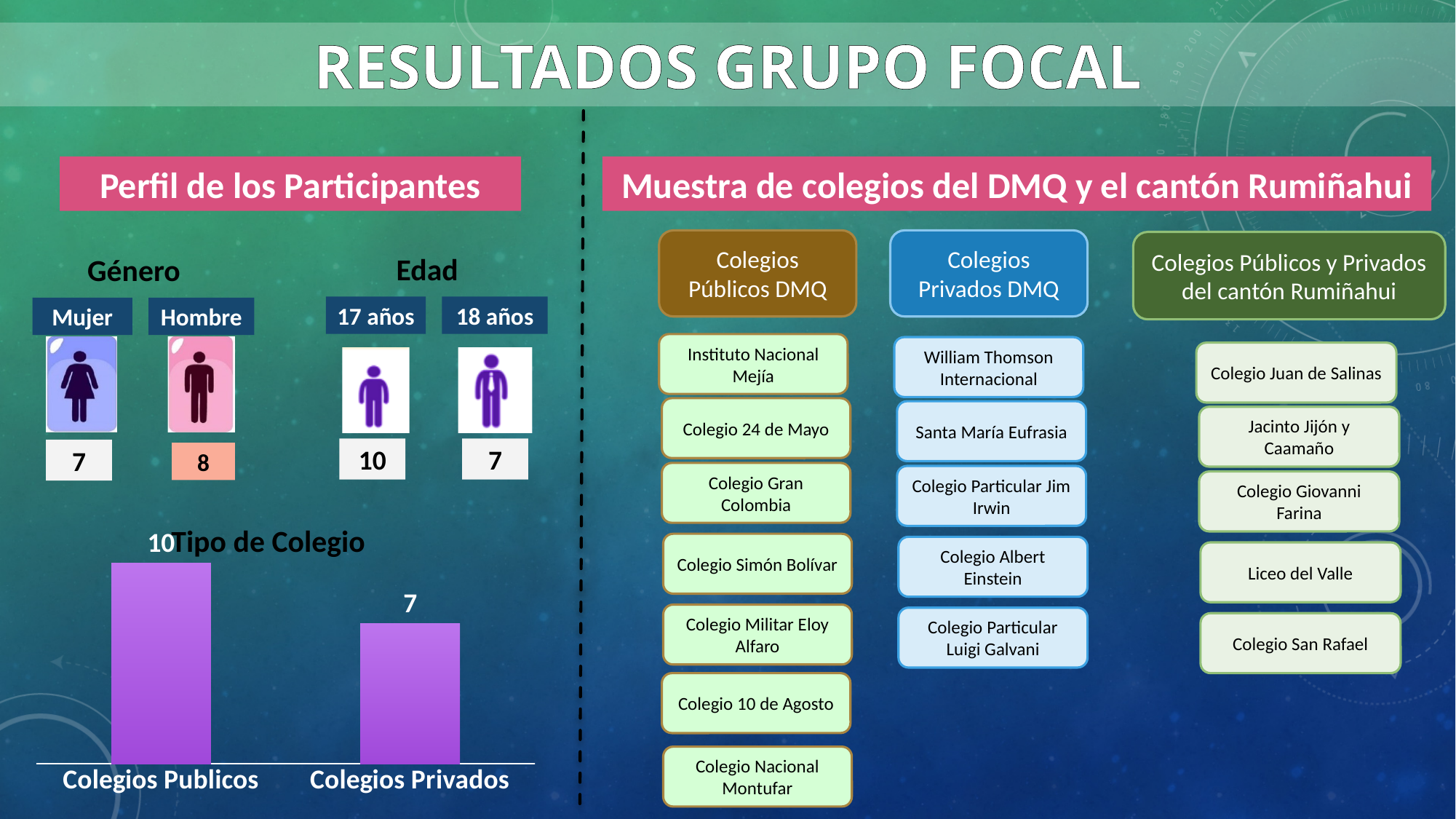
In the "Tipo de Colegio" chart, what is the value for Colegios Publicos? 10 In the "Tipo de Colegio" chart, do the values rise or fall from left to right? Fall What is the total of the two values shown in the "Tipo de Colegio" chart? 17 How many categories does the "Tipo de Colegio" chart show? 2 In the "Tipo de Colegio" chart, which category has the lowest value? Colegios Privados What colour are the bars in the "Tipo de Colegio" chart? Purple What kind of chart is the "Tipo de Colegio" chart? Bar chart In the "Tipo de Colegio" chart, which category has the highest value? Colegios Publicos What is the title of the bar chart on the slide? Tipo de Colegio In the "Tipo de Colegio" chart, which is larger: Colegios Publicos or Colegios Privados? Colegios Publicos In the "Tipo de Colegio" chart, what is the value for Colegios Privados? 7 In the "Tipo de Colegio" chart, what is the difference between the values for Colegios Publicos and Colegios Privados? 3